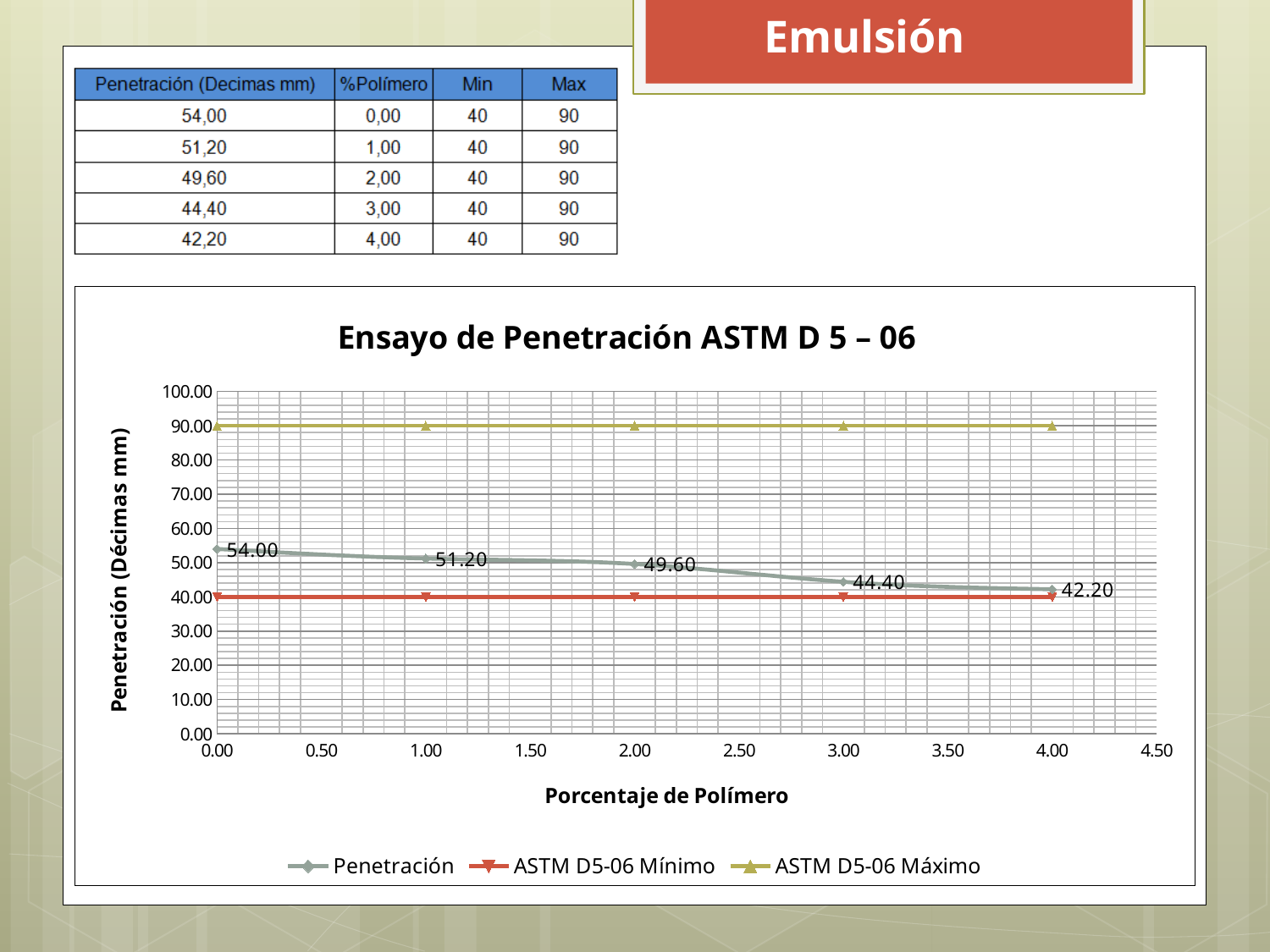
What is the Penetración value at 3.00 percent polymer? 44.40 Is the ASTM D5-06 Máximo line greater or less than 80.00? greater What is the difference between the Penetración values at 0.00 and 4.00 percent polymer? 11.80 What is the Penetración value at 4.00 percent polymer? 42.20 Which is larger, the Penetración value at 1.00 or at 2.00 percent polymer? 1.00 How many data points does the Penetración series have? 5 At which polymer percentage is the Penetración series lowest? 4.00 Does the Penetración series rise or fall as the polymer percentage increases? fall How many series does the legend list? 3 What kind of chart is shown? line chart What is the Penetración value at 0.00 percent polymer? 54.00 At which polymer percentage is the Penetración series highest? 0.00